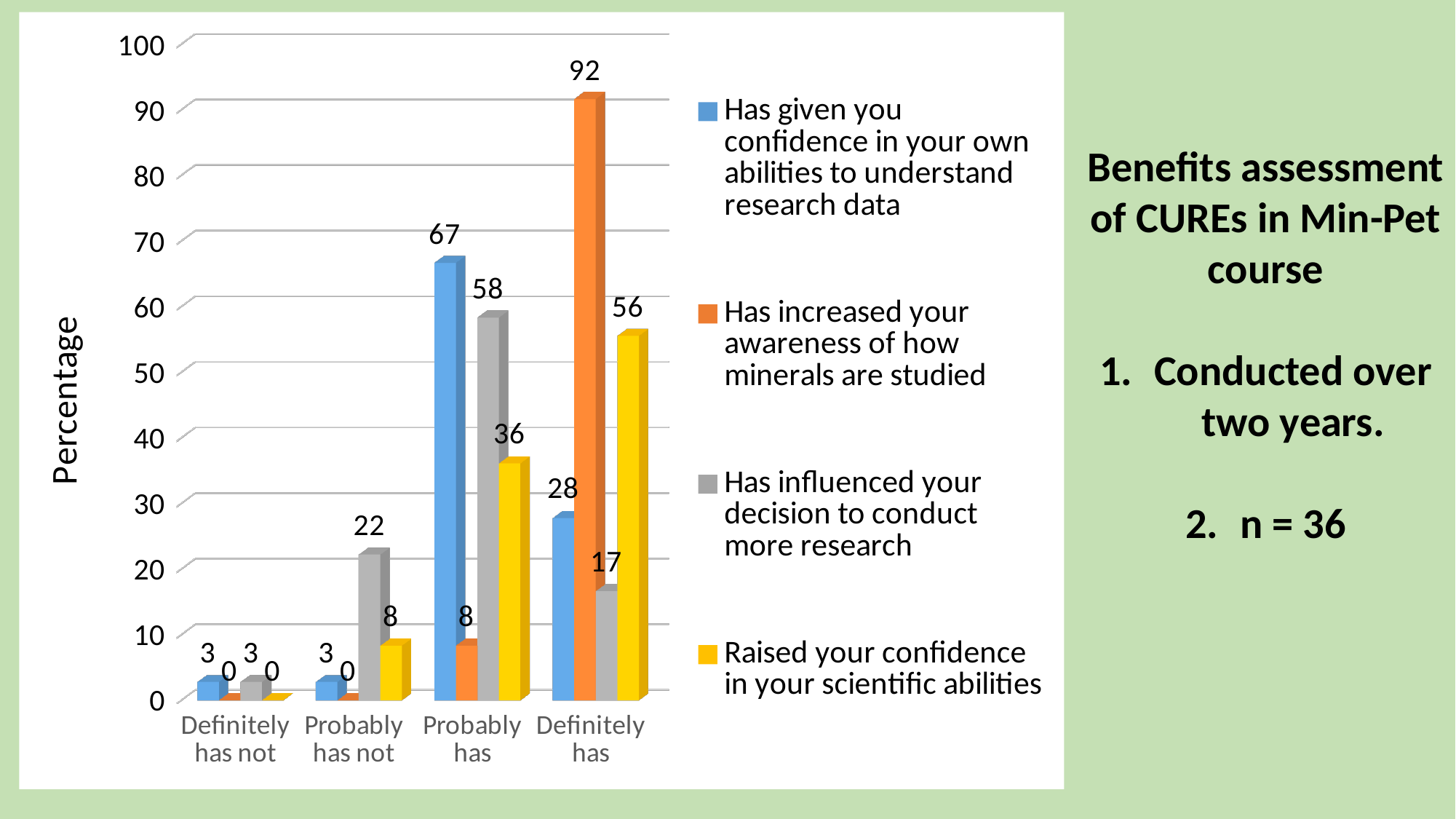
What is the value for "Raised your confidence in your scientific abilities" in the "Definitely has" category? 56 What is the value for "Has given you confidence in your own abilities to understand research data" in the "Probably has" category? 67 How many series does the legend list? 4 In the "Probably has" category, which is larger: "Has given you confidence in your own abilities to understand research data" or "Has influenced your decision to conduct more research"? Has given you confidence in your own abilities to understand research data What kind of chart is shown on the slide? Bar chart What is the difference between the "Has increased your awareness of how minerals are studied" value and the "Has given you confidence in your own abilities to understand research data" value in the "Definitely has" category? 64 How many categories are shown on the x axis? 4 In which category does "Has influenced your decision to conduct more research" have its lowest value? Definitely has not What is the value for "Has increased your awareness of how minerals are studied" in the "Definitely has" category? 92 What is the value for "Has influenced your decision to conduct more research" in the "Probably has not" category? 22 In which category does "Has given you confidence in your own abilities to understand research data" reach its highest value? Probably has What is the label of the vertical axis? Percentage